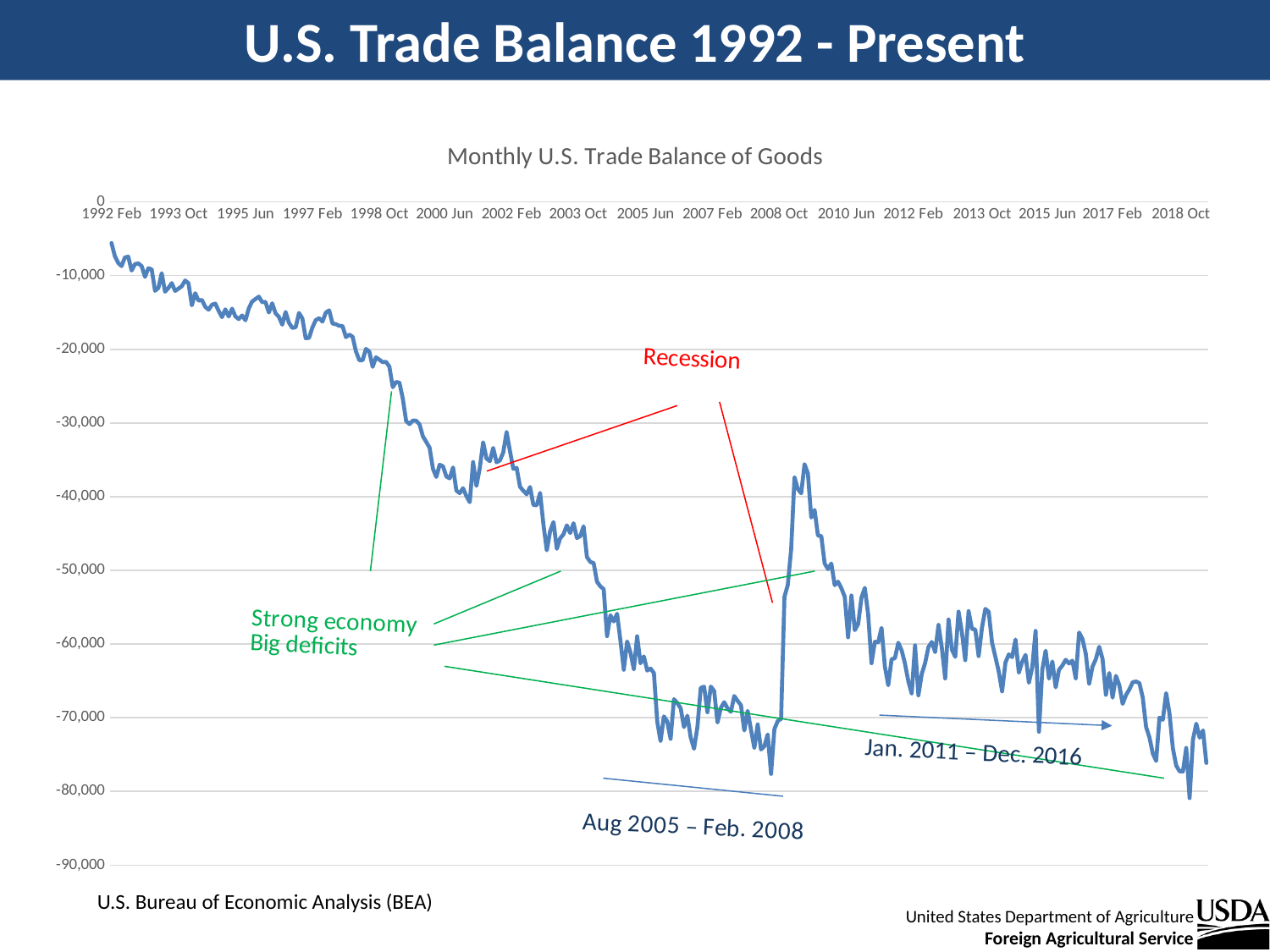
Is the value for 2000 Jun greater or less than -20,000? less Is the value for 2018 Oct greater or less than -70,000? less Which is larger, the trade balance in 1998 Oct or in 2005 Jun? 1998 Oct What is the title of the chart? Monthly U.S. Trade Balance of Goods Is the value for 1992 Feb greater or less than -10,000? greater What kind of chart is shown on the slide? line chart How many data series are plotted on the chart? 1 Which is larger, the trade balance in 1992 Feb or in 2018 Oct? 1992 Feb What is the lowest value shown on the y axis? -90,000 How many date labels are shown on the x axis? 17 Overall, does the trade balance line rise or fall from 1992 Feb to 2018 Oct? fall